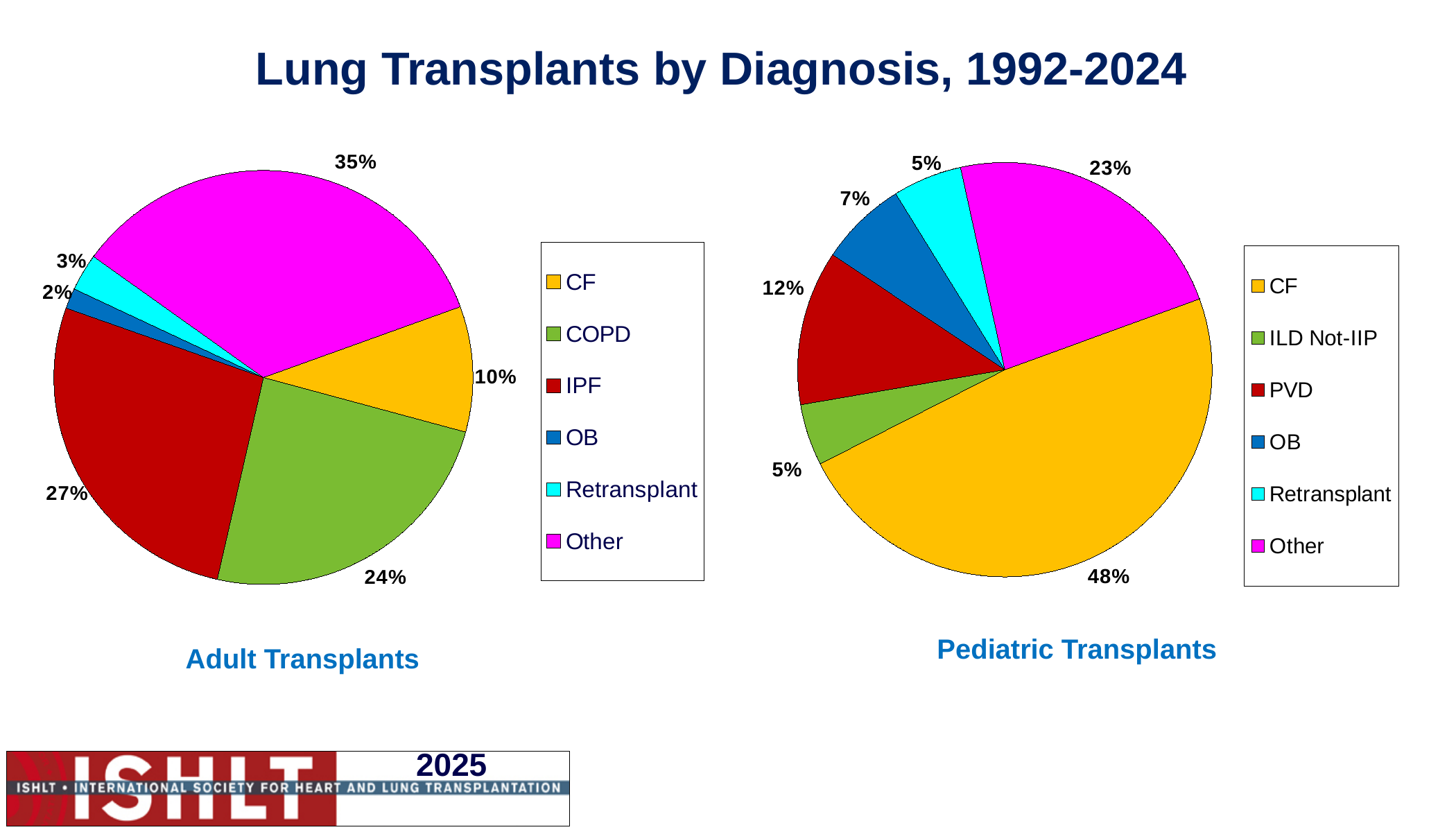
In the Adult Transplants pie chart, what share is labelled for COPD? 24% In the Pediatric Transplants pie chart, what share is labelled for CF? 48% What kind of chart is used for Adult Transplants? Pie chart In the Pediatric Transplants pie chart, which is larger, the share for Other or the share for PVD? Other In the Adult Transplants pie chart, what colour is the Retransplant slice? Cyan In the Adult Transplants pie chart, what is the difference between the Other share and the CF share? 25% In the Pediatric Transplants pie chart, what share is labelled for PVD? 12% In the Adult Transplants pie chart, which diagnosis category has the largest share? Other In the Pediatric Transplants pie chart, which diagnosis category has the largest share? CF In the Adult Transplants pie chart, which diagnosis category has the smallest share? OB In the Adult Transplants pie chart, what share is labelled for IPF? 27% How many categories does the legend of the Pediatric Transplants pie chart list? 6